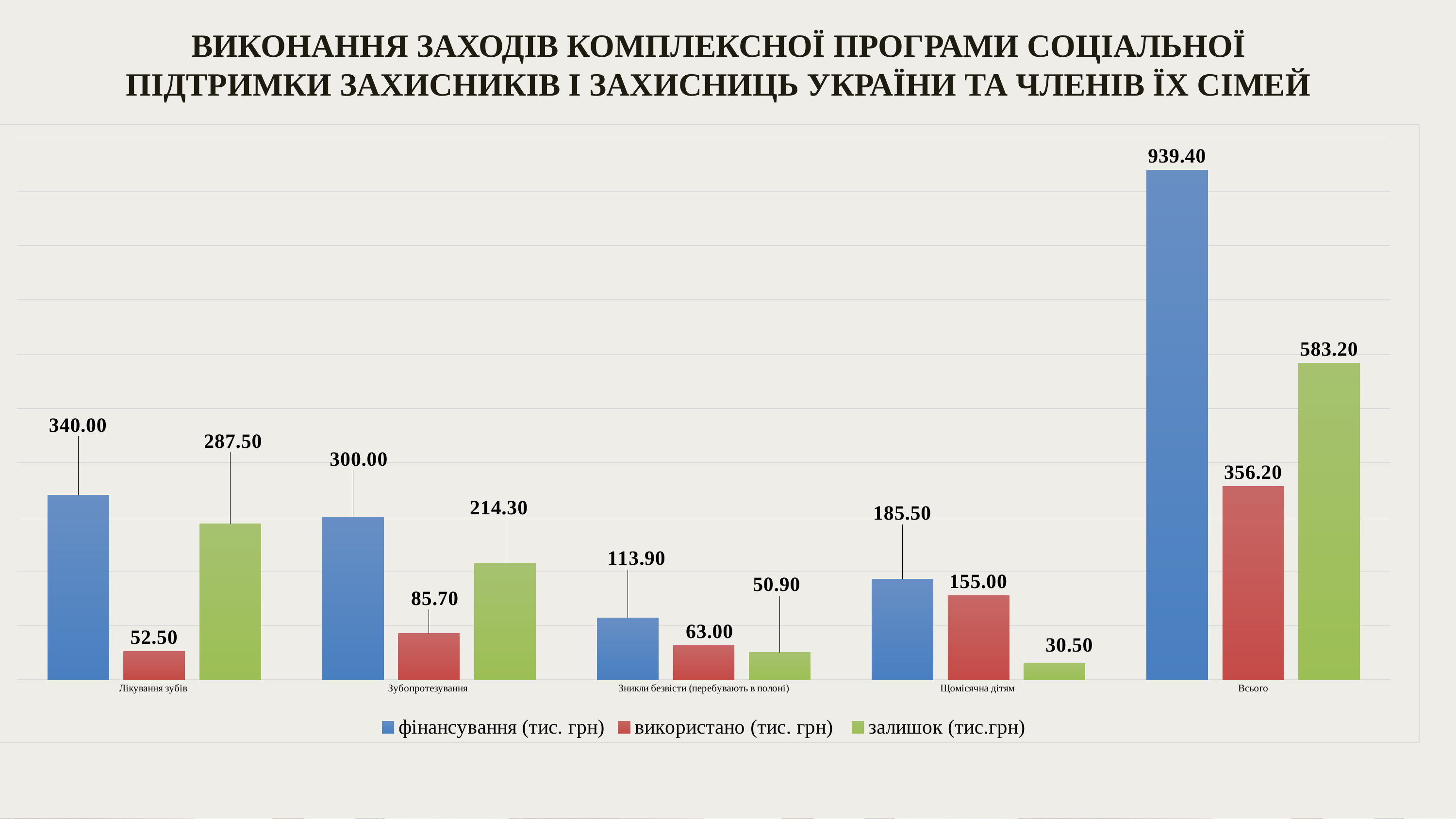
Excluding Всього, which category has the highest value for використано (тис. грн)? Щомісячна дітям What is the value of фінансування (тис. грн) for Всього? 939.40 How many categories are shown on the x axis? 5 What is the value of фінансування (тис. грн) for Лікування зубів? 340.00 Which is larger for Зубопротезування: використано (тис. грн) or залишок (тис.грн)? залишок (тис.грн) What kind of chart is shown on the slide? Bar chart What colour are the bars for the series використано (тис. грн)? Red What is the value of використано (тис. грн) for Зубопротезування? 85.70 Which category has the lowest value for залишок (тис.грн)? Щомісячна дітям What is the difference between фінансування (тис. грн) and використано (тис. грн) for Зникли безвісти (перебувають в полоні)? 50.90 How many series does the legend list? 3 What is the value of залишок (тис.грн) for Щомісячна дітям? 30.50